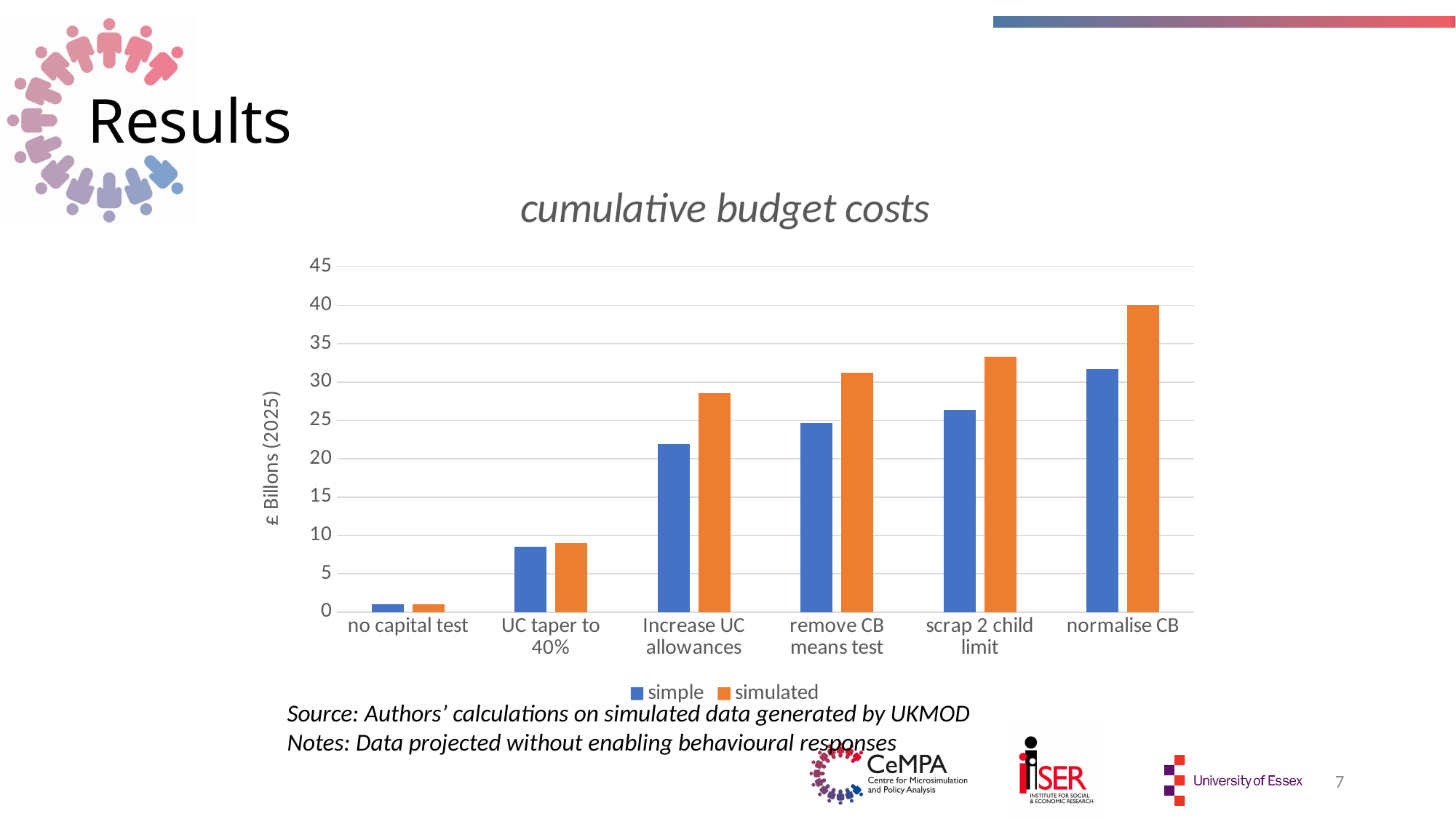
How many categories are shown on the x axis? 6 Is the simulated value for Increase UC allowances greater or less than 25? greater Which is larger for scrap 2 child limit, the simple value or the simulated value? simulated Do the simple values rise or fall moving from left to right along the x axis? rise Which category has the highest simulated value? normalise CB How many series does the legend list? 2 What is the title of the chart? cumulative budget costs What kind of chart is shown on the slide? bar chart Is the simple value for UC taper to 40% greater or less than 10? less What is the label of the y axis? £ Billons (2025) Is the simulated value for normalise CB greater or less than 35? greater Which category has the lowest simple value? no capital test